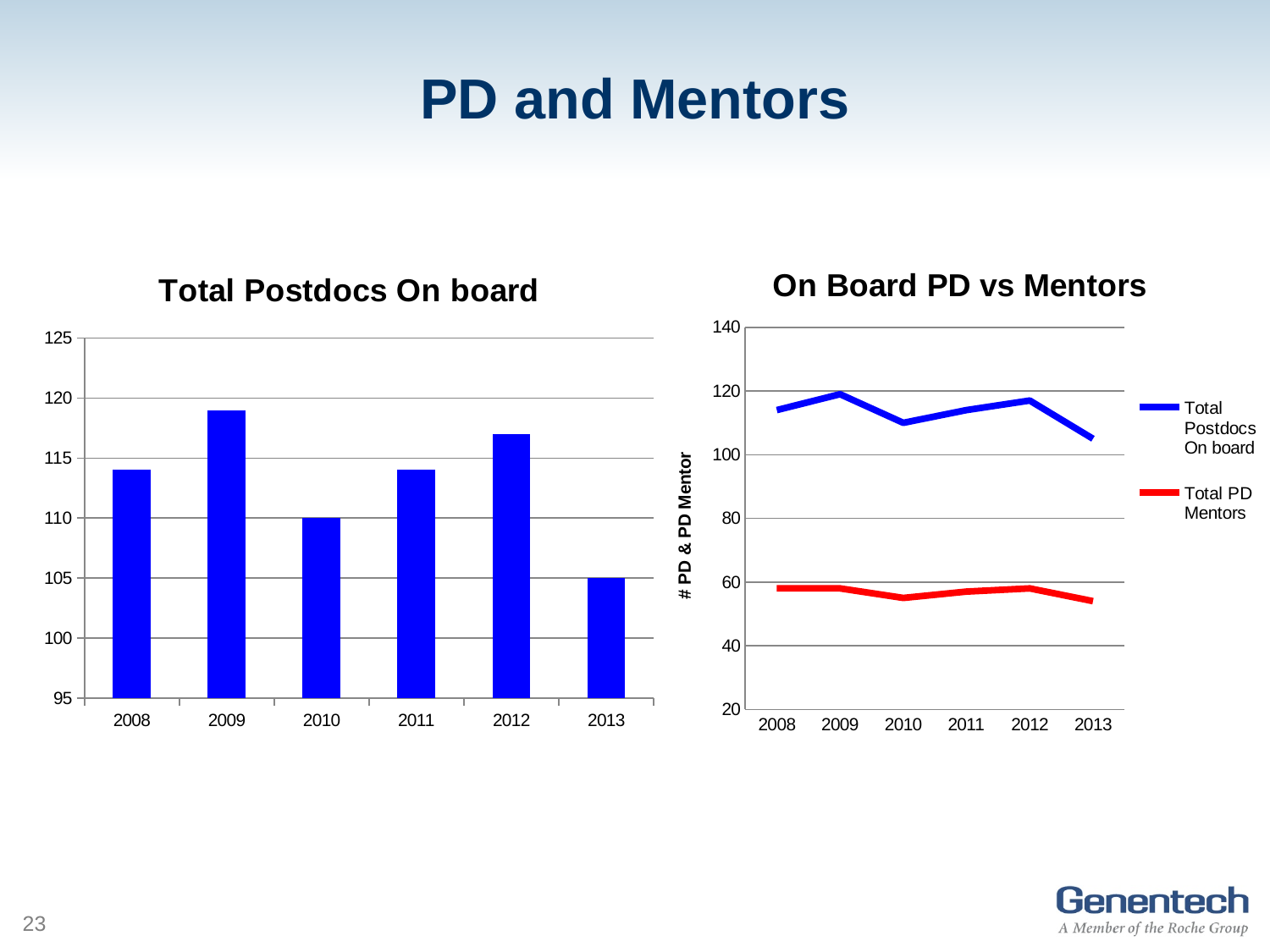
What is the y-axis title of the 'On Board PD vs Mentors' chart? # PD & PD Mentor In the 'Total Postdocs On board' chart, is the value for 2013 greater or less than 110? less In the 'Total Postdocs On board' chart, is the value for 2009 greater or less than 115? greater In the 'Total Postdocs On board' chart, which is larger, the value for 2012 or the value for 2010? 2012 In the 'On Board PD vs Mentors' chart, is the value for Total PD Mentors in 2010 greater or less than 60? less What kind of chart is the 'Total Postdocs On board' chart? bar chart What kind of chart is the 'On Board PD vs Mentors' chart? line chart In the 'Total Postdocs On board' chart, which year has the lowest value? 2013 In the 'Total Postdocs On board' chart, which year has the highest value? 2009 In the 'On Board PD vs Mentors' chart, which series has the higher values, Total Postdocs On board or Total PD Mentors? Total Postdocs On board How many series does the legend of the 'On Board PD vs Mentors' chart list? 2 In the 'Total Postdocs On board' chart, how many years are shown on the x axis? 6